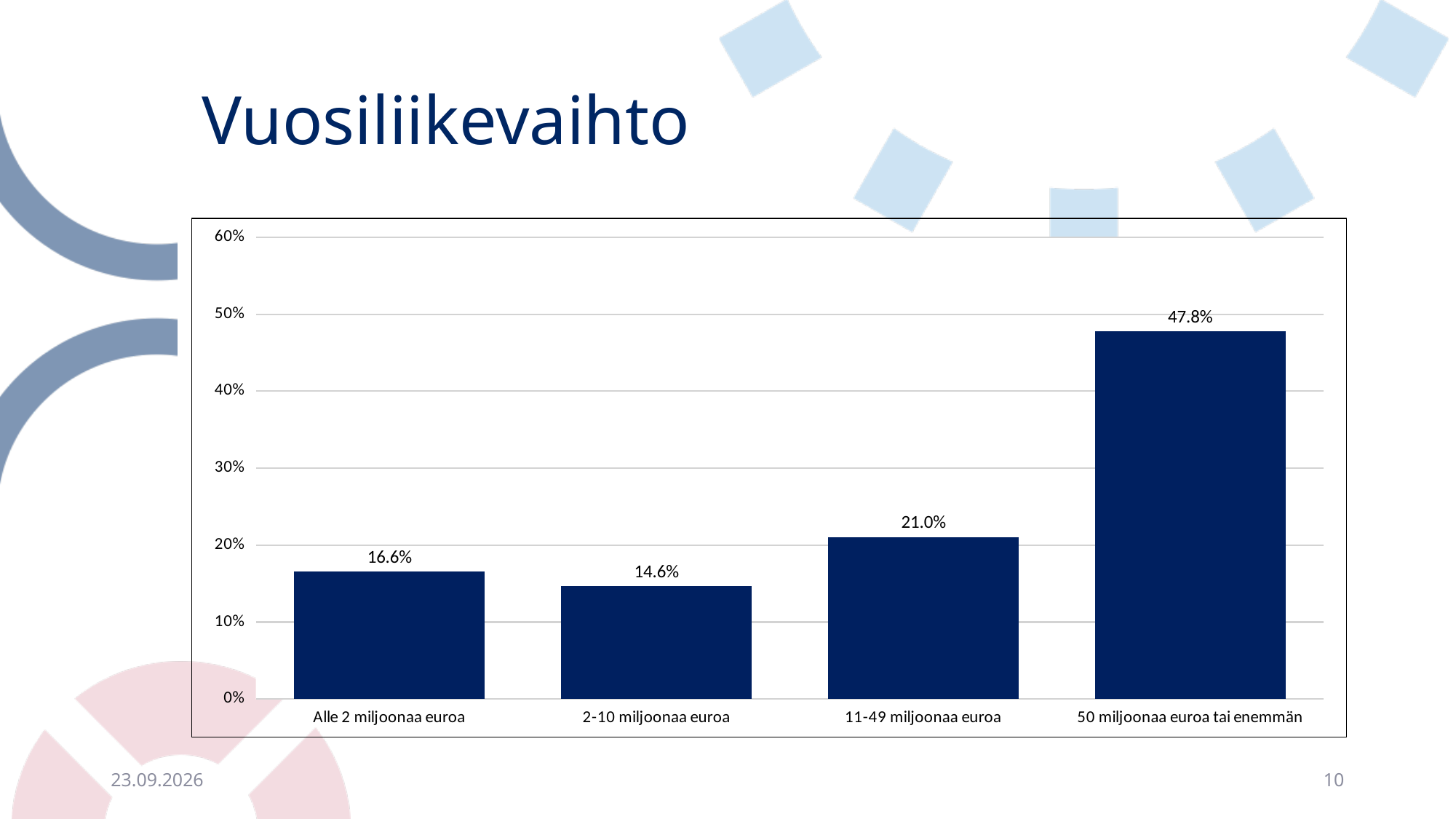
How many categories are shown on the x axis? 4 What kind of chart is shown on the slide? bar chart What is the value for "2-10 miljoonaa euroa"? 14.6% Which is larger, the value for "Alle 2 miljoonaa euroa" or "2-10 miljoonaa euroa"? Alle 2 miljoonaa euroa What is the difference between the values for "50 miljoonaa euroa tai enemmän" and "11-49 miljoonaa euroa"? 26.8% Which category has the highest value? 50 miljoonaa euroa tai enemmän What is the title of the slide? Vuosiliikevaihto What is the value for "50 miljoonaa euroa tai enemmän"? 47.8% What is the value for "11-49 miljoonaa euroa"? 21.0% Which category has the lowest value? 2-10 miljoonaa euroa What is the value for "Alle 2 miljoonaa euroa"? 16.6% Is the value for "50 miljoonaa euroa tai enemmän" greater or less than 40%? greater